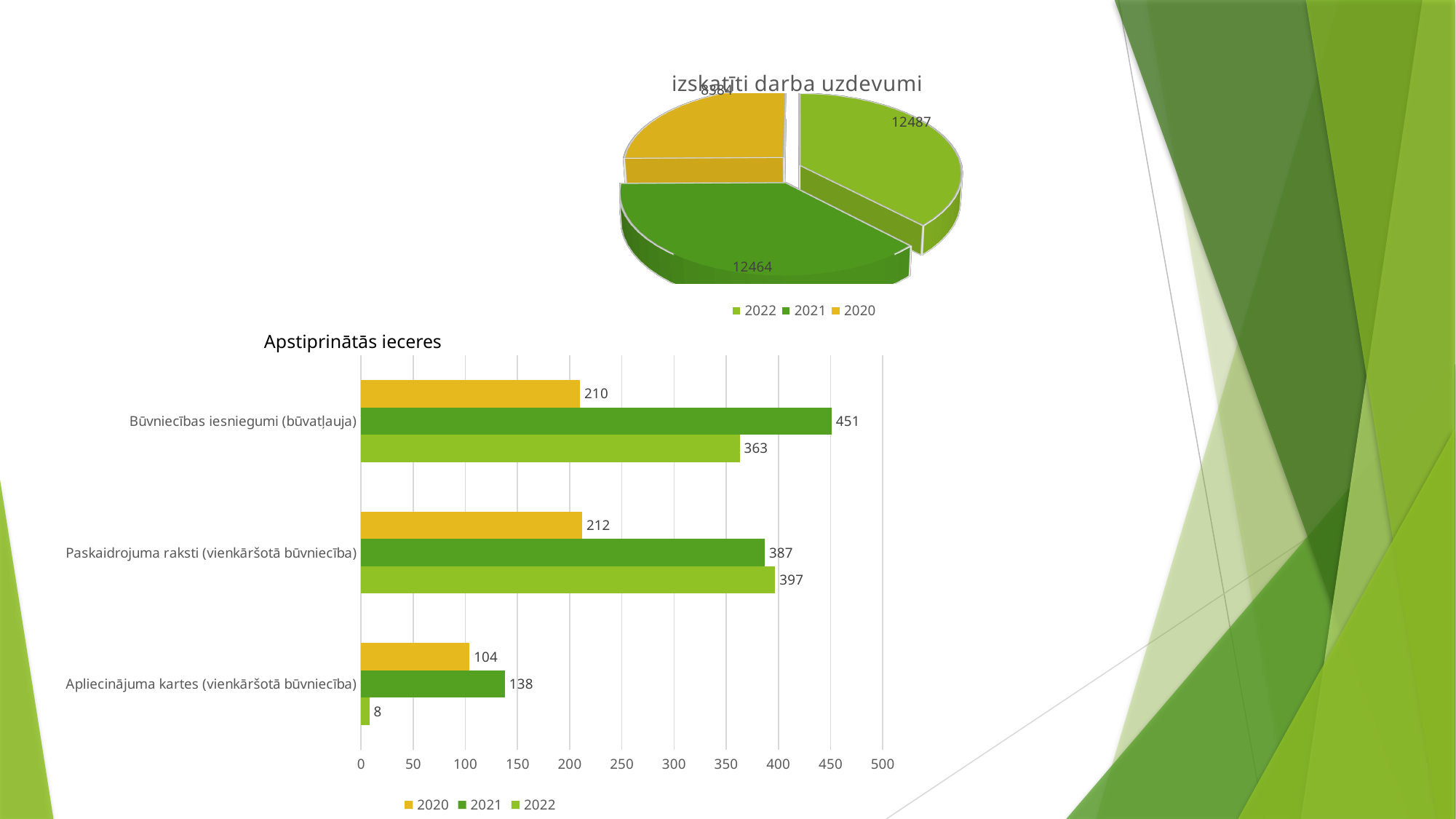
What kind of chart is 'izskatīti darba uzdevumi'? Pie chart What kind of chart is 'Apstiprinātās ieceres'? Bar chart In the bar chart 'Apstiprinātās ieceres', how many series does the legend list? 3 In the bar chart 'Apstiprinātās ieceres', what is the value for 2021 for Būvniecības iesniegumi (būvatļauja)? 451 In the pie chart 'izskatīti darba uzdevumi', what is the difference between the 2022 and 2021 values? 23 In the bar chart 'Apstiprinātās ieceres', which year has the highest value for Paskaidrojuma raksti (vienkāršotā būvniecība)? 2022 In the bar chart 'Apstiprinātās ieceres', which year has the lowest value for Apliecinājuma kartes (vienkāršotā būvniecība)? 2022 In the bar chart 'Apstiprinātās ieceres', how many categories are shown on the vertical axis? 3 In the bar chart 'Apstiprinātās ieceres', what is the value for 2022 for Apliecinājuma kartes (vienkāršotā būvniecība)? 8 In the bar chart 'Apstiprinātās ieceres', which is larger for Apliecinājuma kartes (vienkāršotā būvniecība): the 2020 value or the 2021 value? 2021 In the bar chart 'Apstiprinātās ieceres', what is the difference between the 2021 and 2022 values for Būvniecības iesniegumi (būvatļauja)? 88 In the pie chart 'izskatīti darba uzdevumi', what is the value for 2022? 12487